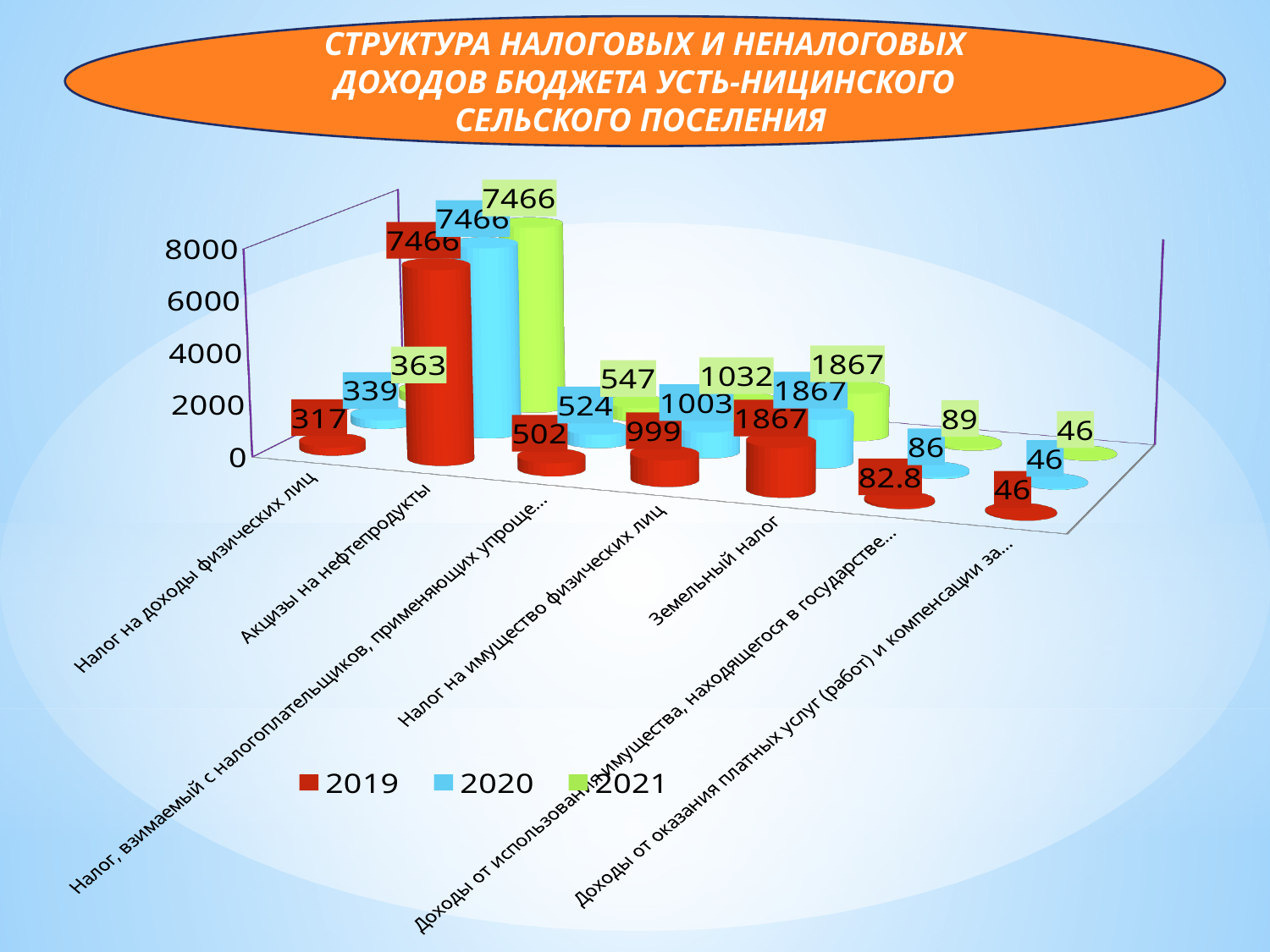
What is the 2020 value for Земельный налог? 1867 How much higher is the 2021 value than the 2019 value for Налог на доходы физических лиц? 46 Which is larger in 2019: Земельный налог or Налог на имущество физических лиц? Земельный налог How many series does the legend list? 3 What is the 2021 value for Налог на имущество физических лиц? 1032 Which category has the highest 2021 value? Акцизы на нефтепродукты Which category has the lowest 2019 value? Доходы от оказания платных услуг (работ) и компенсации за... How many categories are shown on the x axis? 7 What is the 2019 value for Налог на доходы физических лиц? 317 What is the 2019 value for Доходы от использования имущества, находящегося в государстве...? 82.8 What kind of chart is shown on the slide? bar chart What is the difference between the 2021 and 2019 values for Налог, взимаемый с налогоплательщиков, применяющих упроще...? 45